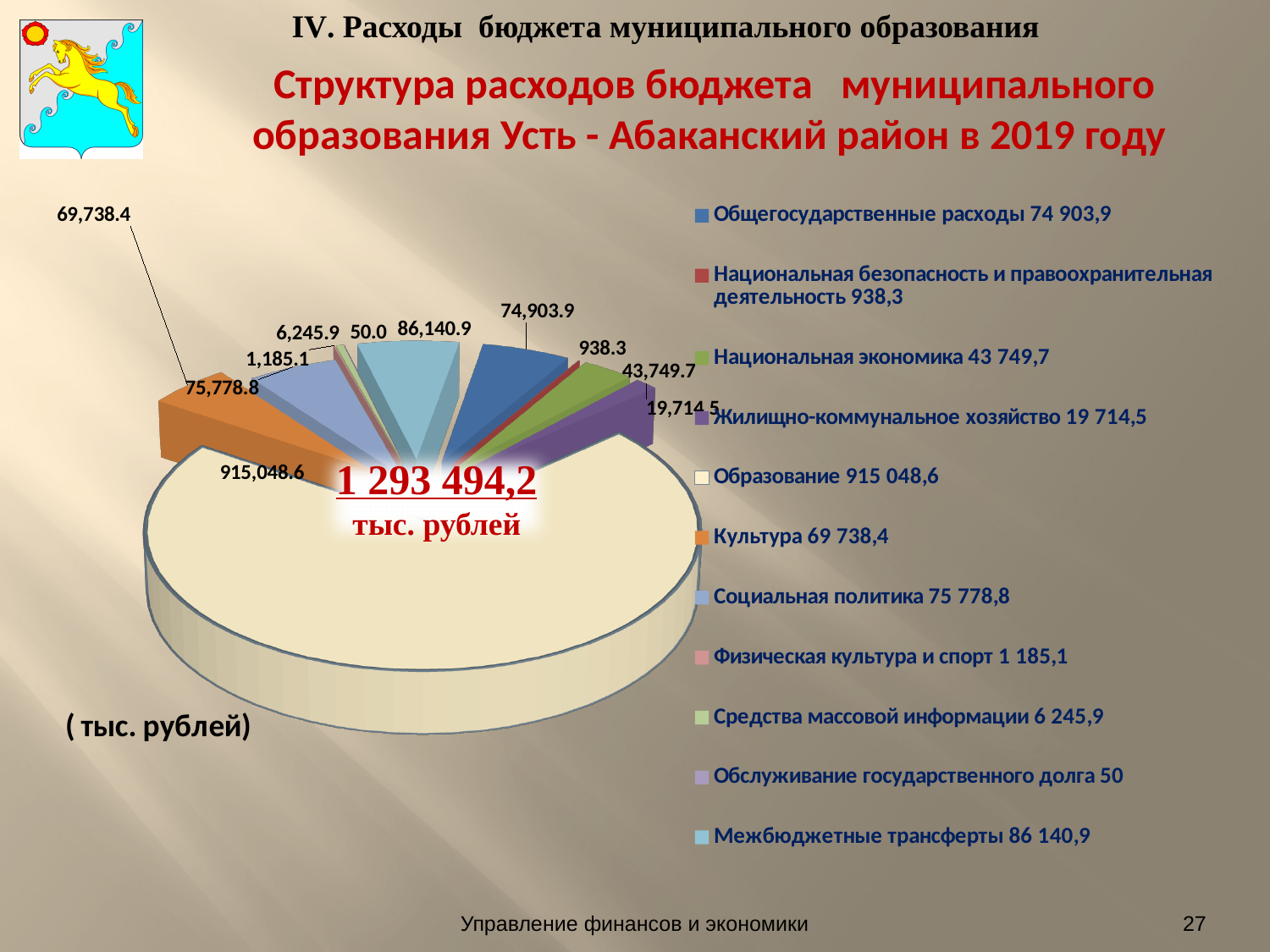
What is the difference between Социальная политика (75 778,8) and Культура (69 738,4)? 6 040,4 Which is larger: Социальная политика or Культура? Социальная политика What share of the total (1 293 494,2) does Образование (915 048,6) represent? 70.7% How many categories (slices) does the pie chart have? 11 In what units are the values of the chart given, as stated below the pie? тыс. рублей Which category has the largest slice of the pie chart? Образование What is the value for Жилищно-коммунальное хозяйство? 19 714,5 What is the value for Образование according to the legend? 915 048,6 What is the value for Межбюджетные трансферты according to the legend? 86 140,9 What total amount is printed in the centre of the pie chart? 1 293 494,2 тыс. рублей Which category has the smallest value in the pie chart? Обслуживание государственного долга What type of chart is shown on the slide? Pie chart